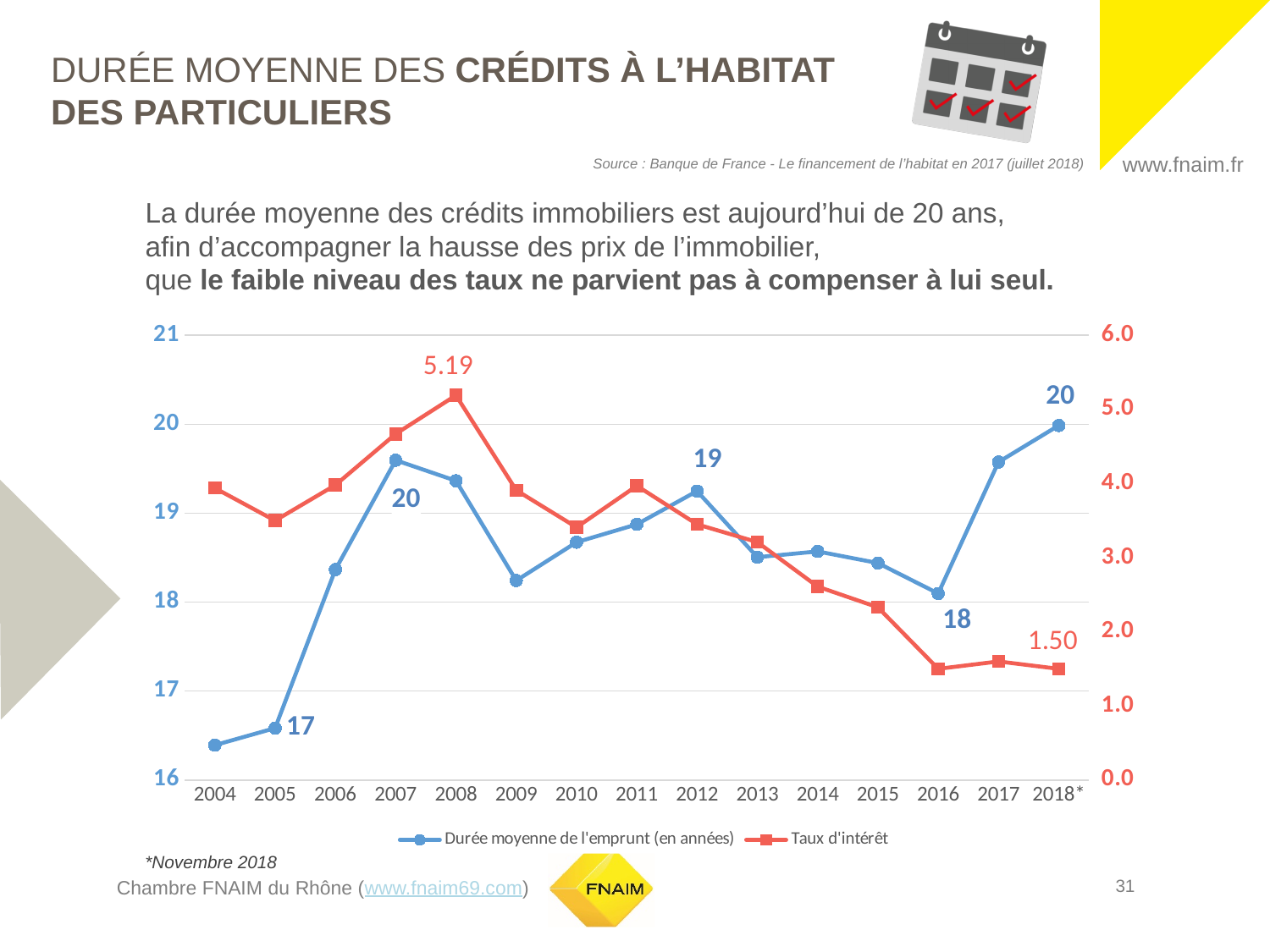
How many series does the chart legend list? 2 What is the 'Taux d'intérêt' value labelled for 2008? 5.19 What is the 'Taux d'intérêt' value labelled for 2018*? 1.50 Is the 'Taux d'intérêt' value for 2015 greater or less than 2.0? greater Is the 'Durée moyenne de l'emprunt' value for 2004 greater or less than 17? less What is the value of 'Durée moyenne de l'emprunt (en années)' for 2018*? 20 What is the difference between the 'Taux d'intérêt' values labelled for 2008 and 2018*? 3.69 How many years are shown on the x axis of the chart? 15 What is the labelled value of 'Durée moyenne de l'emprunt (en années)' for 2016? 18 What kind of chart is shown on the slide? Line chart What is the labelled value of 'Durée moyenne de l'emprunt (en années)' for 2005? 17 In which year does the 'Taux d'intérêt' series reach its highest value? 2008